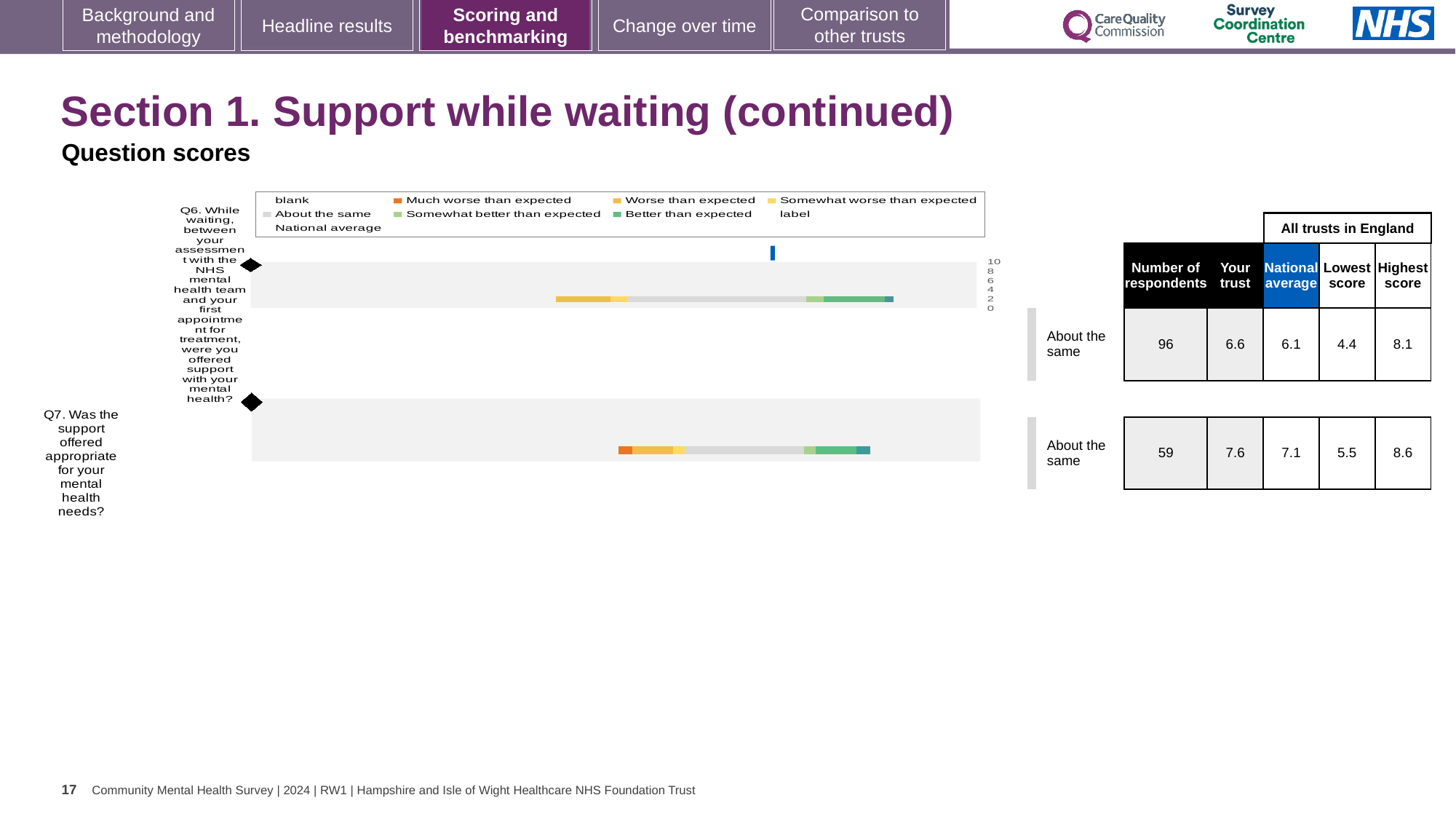
What benchmarking category is the trust's score for Q6 placed in? About the same What is the difference between the 'Your trust' scores for Q7 and Q6? 1.0 What is the 'Your trust' score for Q7 (was the support offered appropriate for your mental health needs)? 7.6 What kind of chart is shown on the slide? bar chart What is the highest score among all trusts in England for Q6? 8.1 How many questions (bars) are plotted in the chart? 2 What is the 'Your trust' score for Q6 (support while waiting between assessment and first appointment)? 6.6 What is the national average score for Q7? 7.1 How many respondents answered Q7? 59 What is the lowest score among all trusts in England for Q7? 5.5 Which question has the higher 'Your trust' score, Q6 or Q7? Q7 What is the national average score for Q6? 6.1